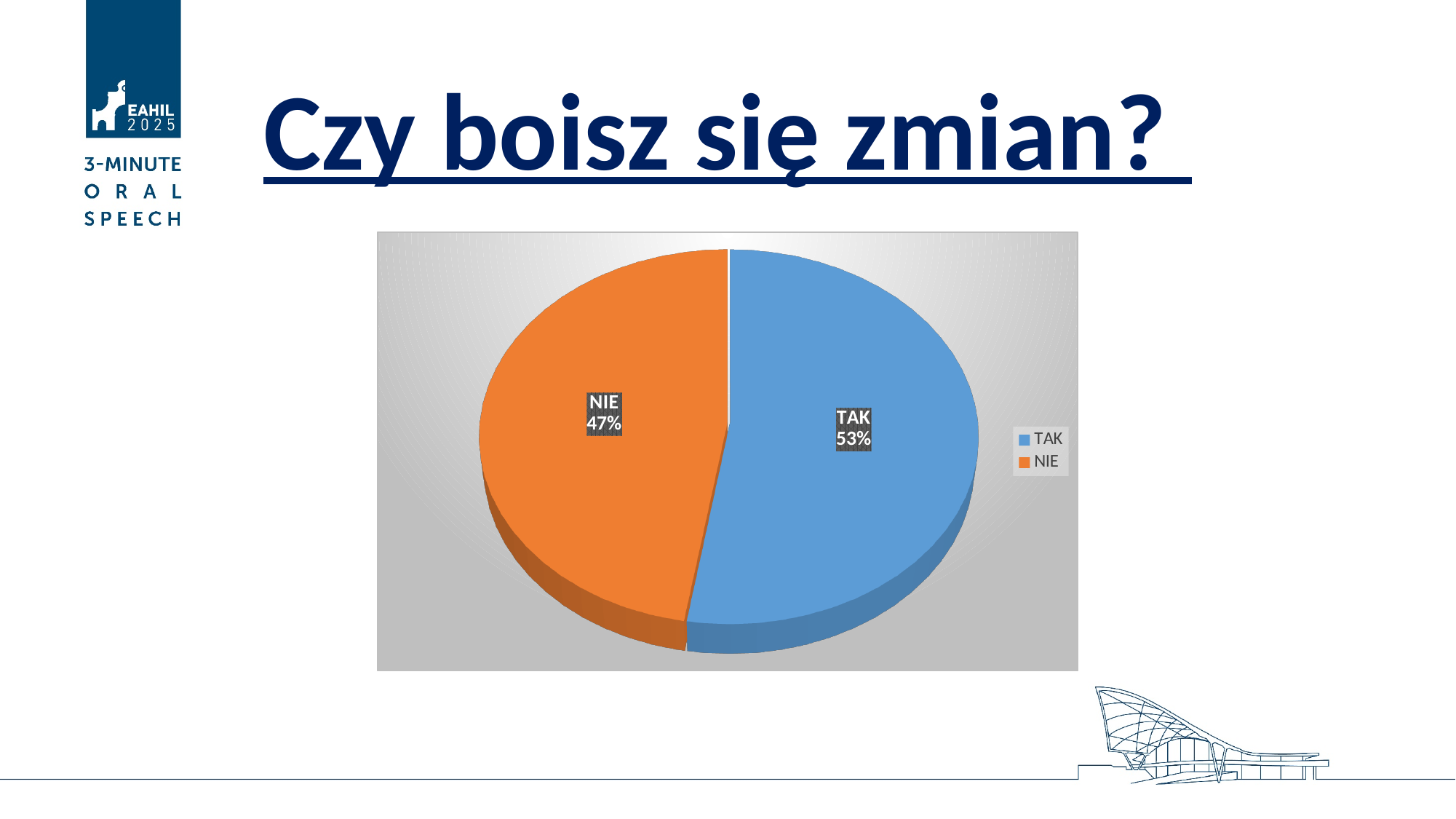
What is the title of the slide above the chart? Czy boisz się zmian? Which slice of the pie is the smallest? NIE Which slice of the pie is the largest? TAK What colour is the NIE slice? orange Which slice is larger, TAK or NIE? TAK What percentage of the pie is labelled TAK? 53% What share of the pie does the TAK slice represent? 53% What kind of chart is shown on the slide? pie chart What is the difference in percentage points between the TAK and NIE slices? 6 How many slices does the pie chart have? 2 What percentage of the pie is labelled NIE? 47% How many entries does the legend list? 2